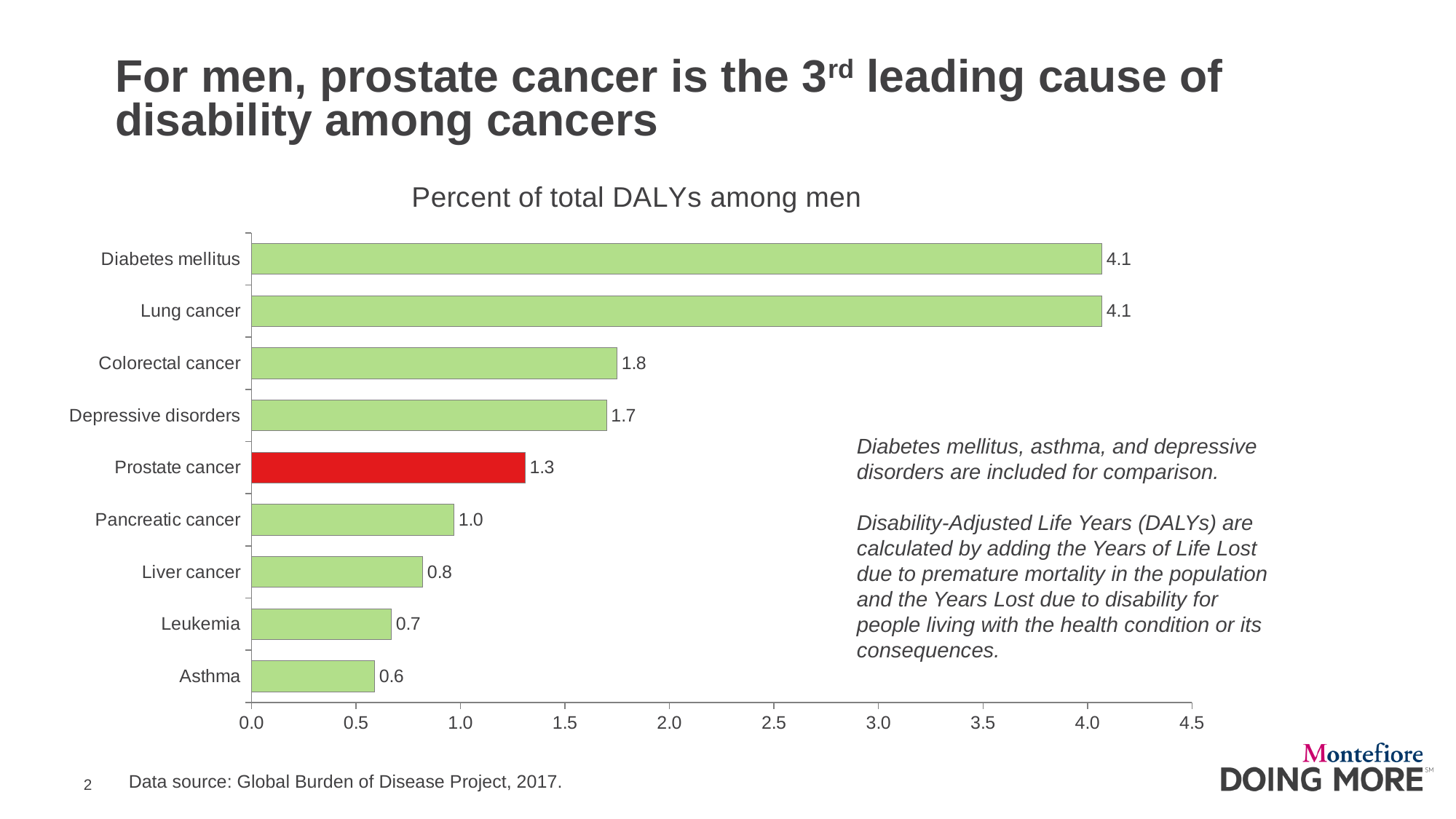
How many categories are shown in the chart? 9 What is the value for Leukemia? 0.7 Which category has the lowest value? Asthma Is the value for Liver cancer greater or less than 1.0? less What is the value for Prostate cancer? 1.3 Which category's bar is coloured red? Prostate cancer Which is larger, the value for Depressive disorders or the value for Prostate cancer? Depressive disorders What kind of chart is shown on the slide? bar chart What is the value for Lung cancer? 4.1 What is the value for Colorectal cancer? 1.8 What is the difference between the values for Diabetes mellitus and Pancreatic cancer? 3.1 What is the difference between the values for Colorectal cancer and Prostate cancer? 0.5